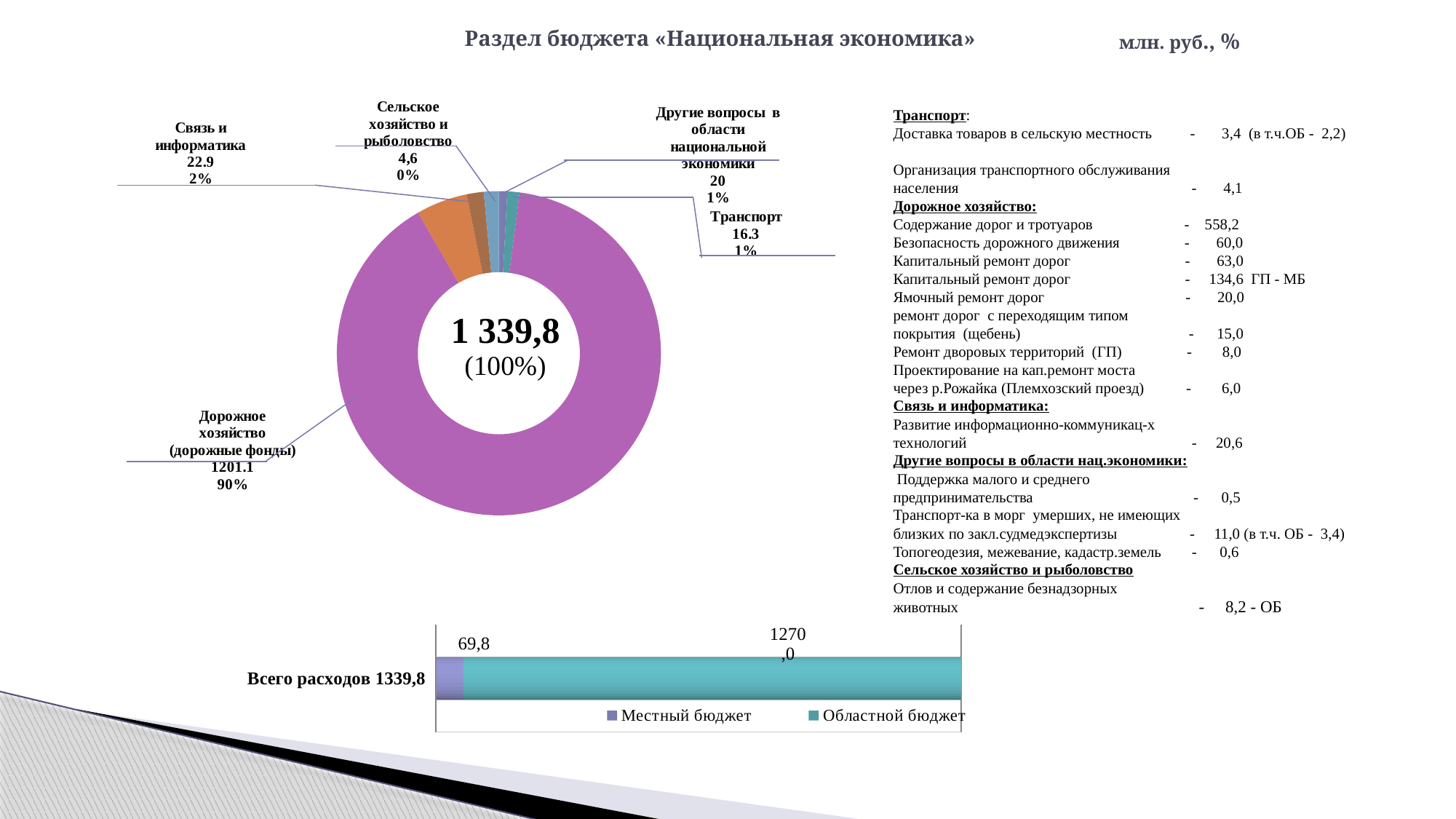
In the donut chart, what is the value for Связь и информатика? 22.9 In the donut chart, what total value is shown in the centre? 1 339,8 In the donut chart, what is the value for Транспорт? 16.3 In the donut chart, what percentage share is shown for Дорожное хозяйство (дорожные фонды)? 90% How many series does the legend of the bar chart at the bottom list? 2 In the donut chart, which category has the smallest value? Сельское хозяйство и рыболовство In the bar chart at the bottom, what is the value for Областной бюджет? 1270,0 In the donut chart, what is the value for Дорожное хозяйство (дорожные фонды)? 1201.1 In the donut chart, which category has the largest value? Дорожное хозяйство (дорожные фонды) In the donut chart, which is larger: Связь и информатика or Транспорт? Связь и информатика In the donut chart, what percentage share is shown for Сельское хозяйство и рыболовство? 0% In the bar chart at the bottom, what is the value for Местный бюджет? 69,8